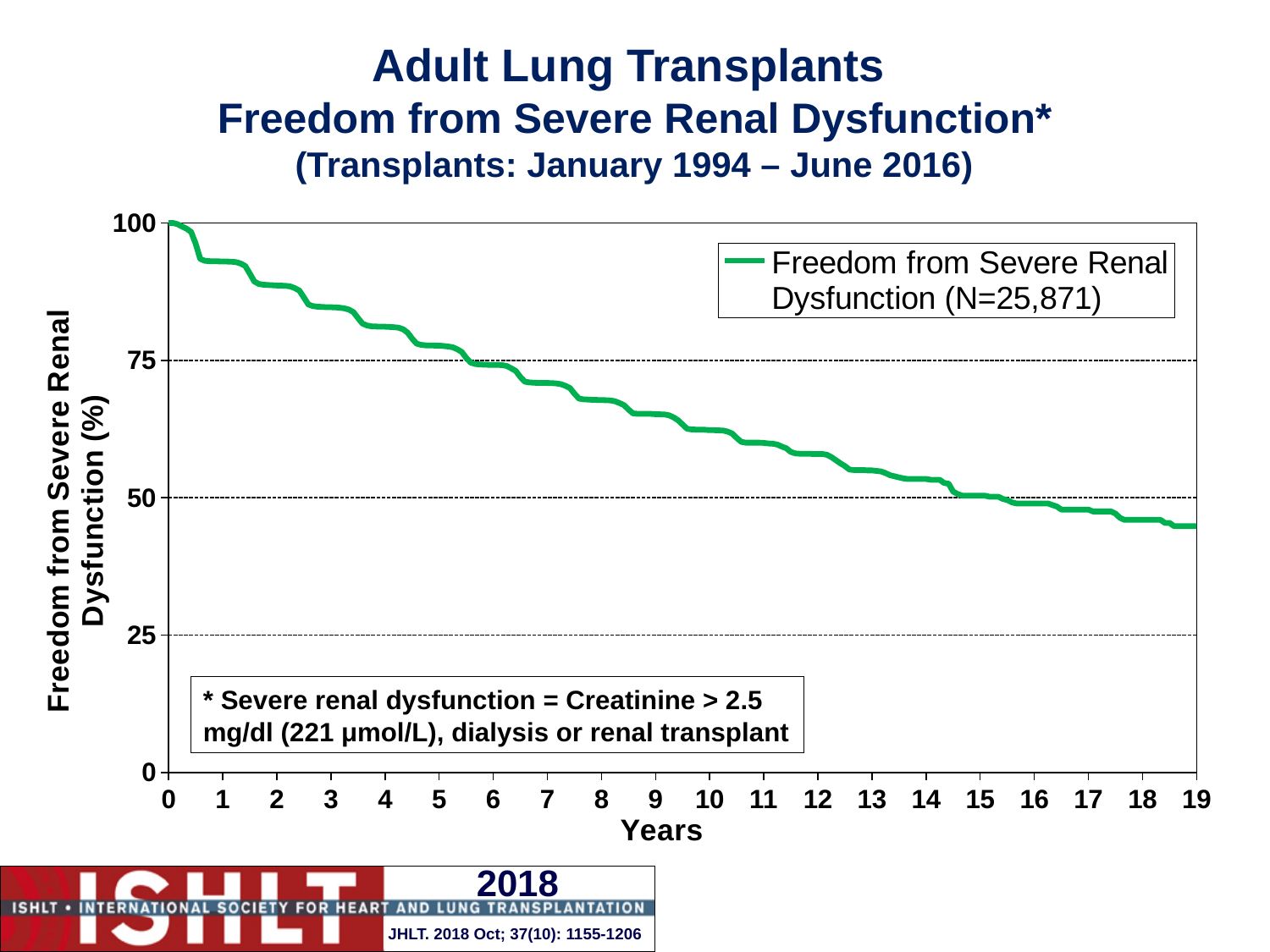
Is the freedom from severe renal dysfunction at year 8 greater or less than 75? less What kind of chart is shown on the slide? line chart Does the freedom from severe renal dysfunction rise or fall as the years increase? fall What is the number of patients (N) given in the legend? 25,871 What is the freedom from severe renal dysfunction at year 0? 100 How many series does the legend list? 1 What is the highest year shown on the x axis? 19 Is the freedom from severe renal dysfunction at year 18 greater or less than 50? less What is the label of the x axis? Years Is the freedom from severe renal dysfunction at year 4 greater or less than 75? greater